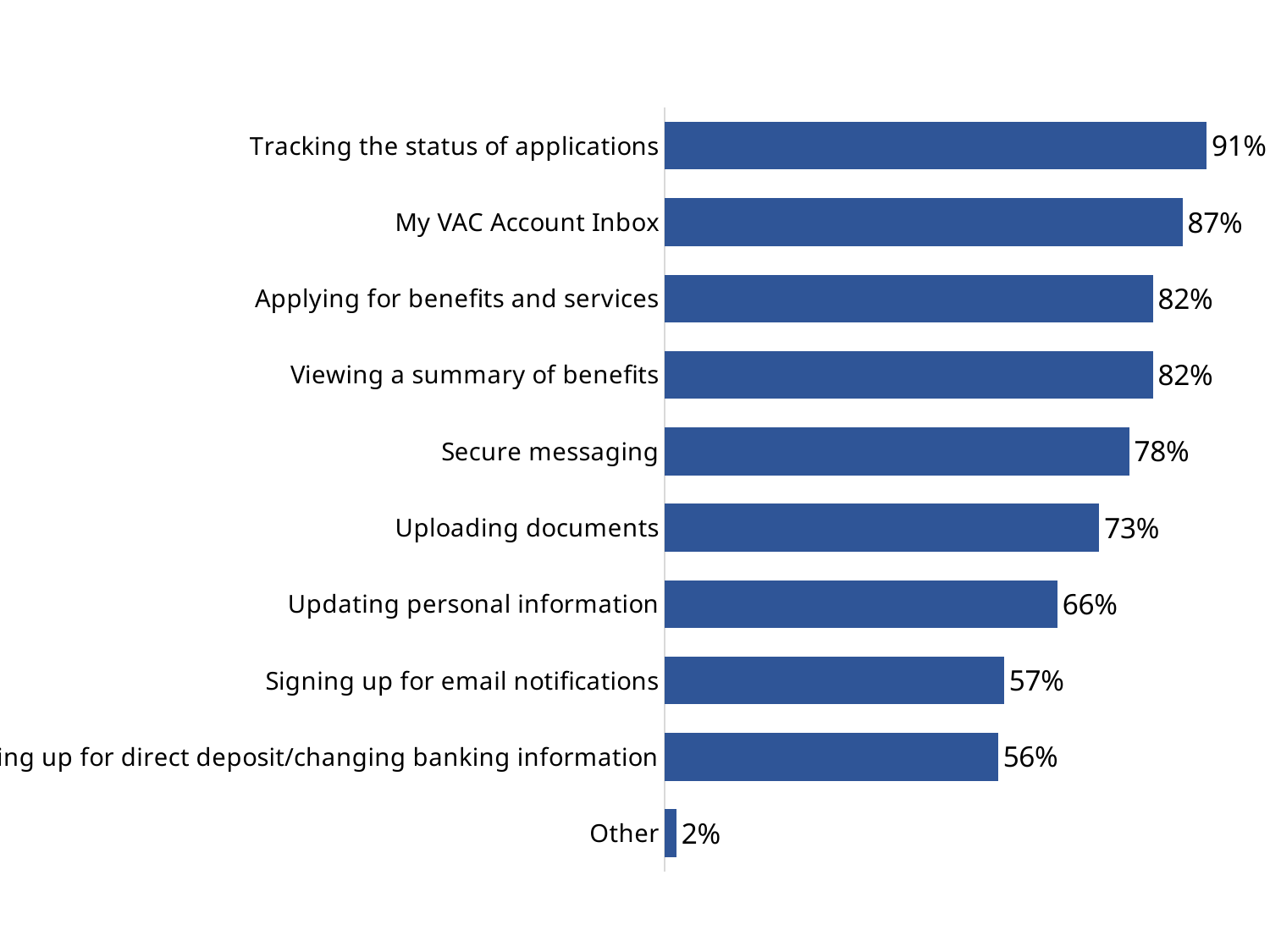
Which is larger, the value for Secure messaging or the value for Updating personal information? Secure messaging What is the difference between the values for Tracking the status of applications and My VAC Account Inbox? 4% What is the value for Uploading documents? 73% What is the value for Tracking the status of applications? 91% Which category has the lowest value? Other What kind of chart is shown on the slide? Bar chart What is the value for Signing up for email notifications? 57% How many categories are shown in the chart? 10 What is the value for My VAC Account Inbox? 87% What is the difference between the values for Uploading documents and Updating personal information? 7% What is the value for Secure messaging? 78% Which category has the highest value? Tracking the status of applications